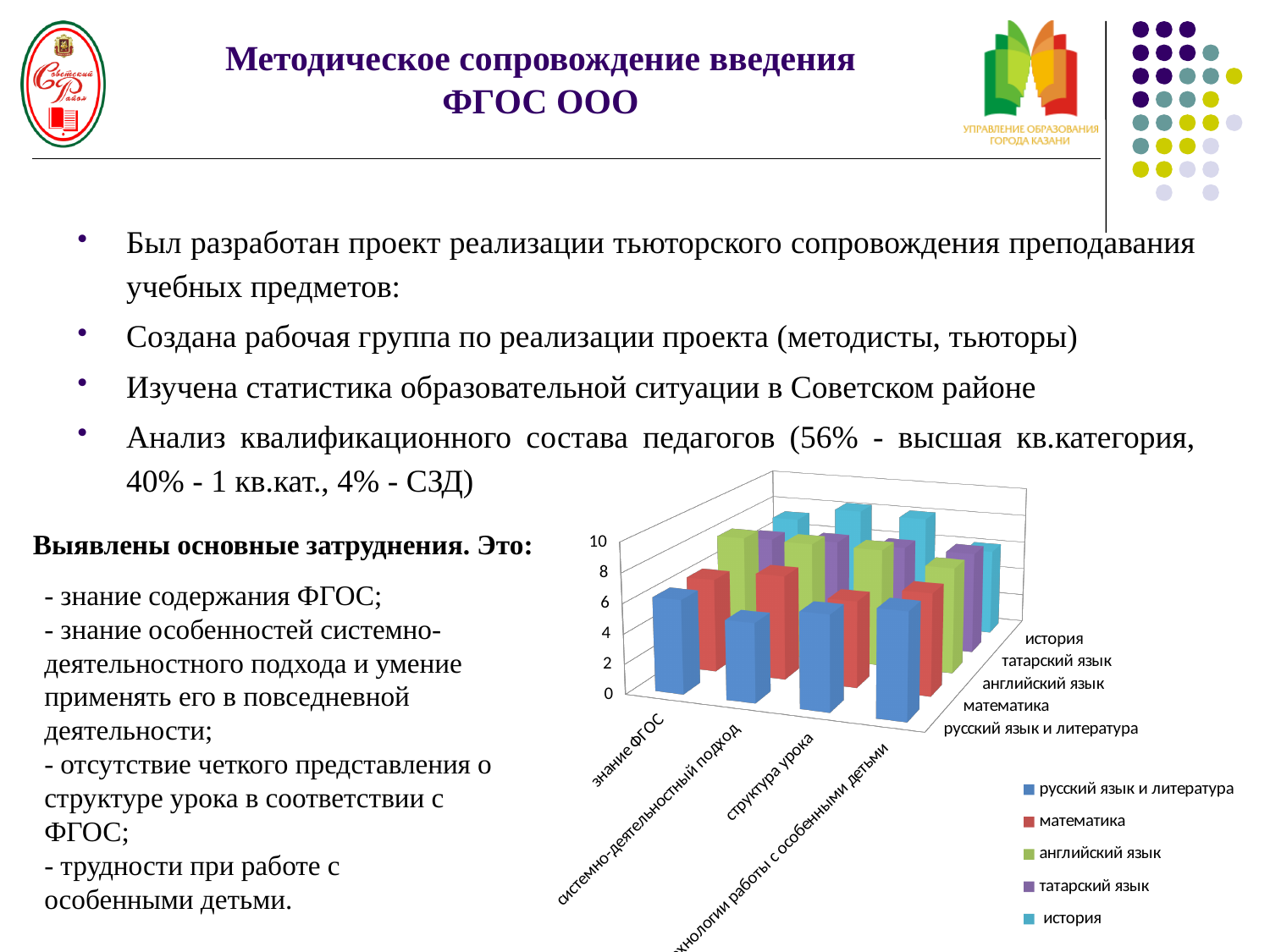
What is the first category label on the chart's x axis? знание ФГОС What is the highest value shown on the chart's vertical axis? 10 How many categories are shown along the x axis of the chart? 4 Which series is listed last in the chart legend? история How many series does the chart legend list? 5 What kind of chart is shown on the slide? bar chart Which series is listed first in the chart legend? русский язык и литература